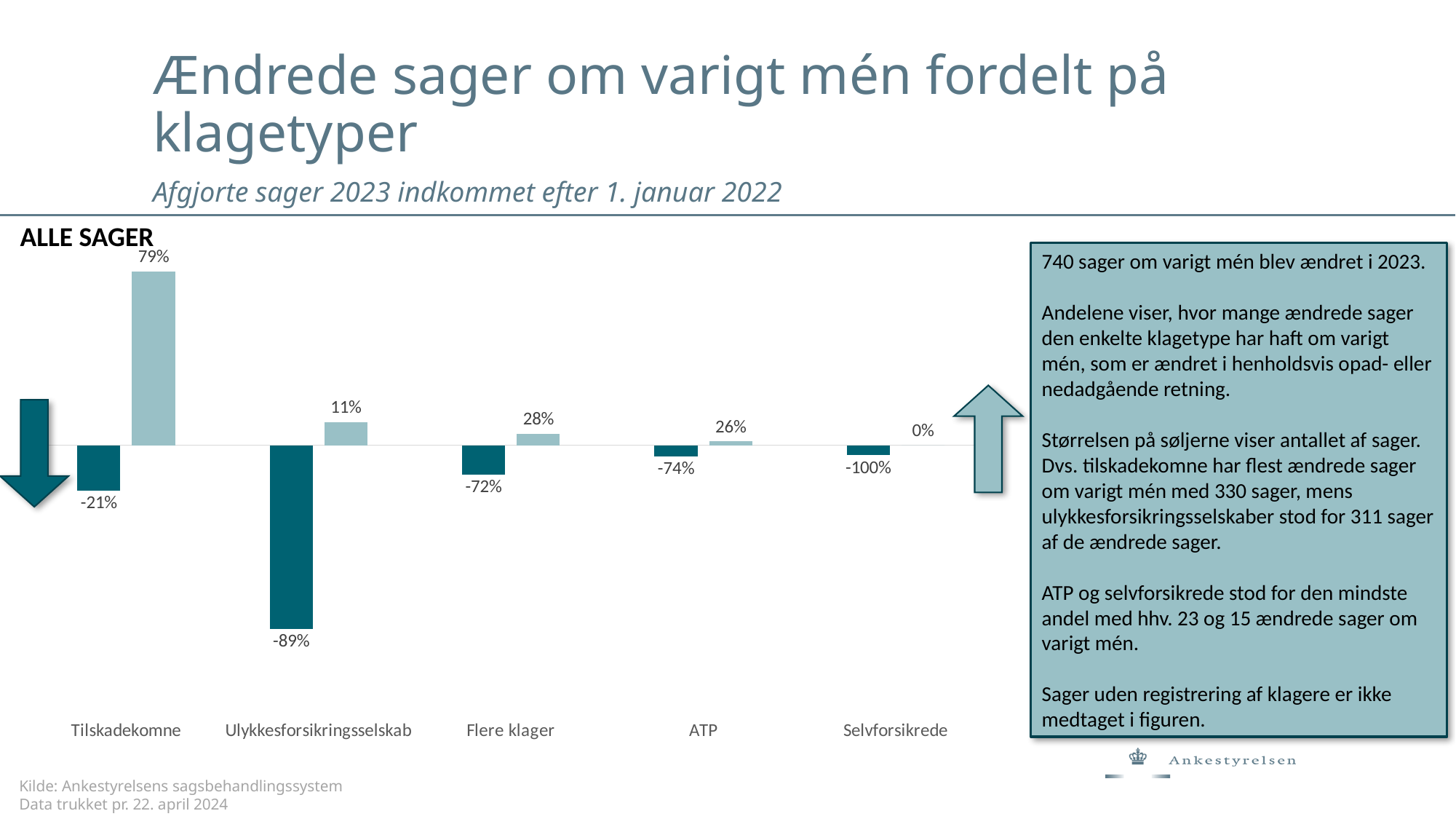
What is the title printed above the chart? ALLE SAGER How many categories are shown on the x axis? 5 What is the upward (light) value for Tilskadekomne? 79% What is the downward (dark) value for Ulykkesforsikringsselskab? -89% What is the downward (dark) value for Selvforsikrede? -100% Which category has the highest upward (light) value? Tilskadekomne What is the difference between the upward values for Tilskadekomne (79%) and Ulykkesforsikringsselskab (11%)? 68 percentage points What is the downward (dark) value for Flere klager? -72% What kind of chart is shown on the slide? Bar chart What is the upward (light) value for ATP? 26% Which is larger, the upward value for Flere klager or the upward value for ATP? Flere klager Which category has the lowest upward (light) value? Selvforsikrede